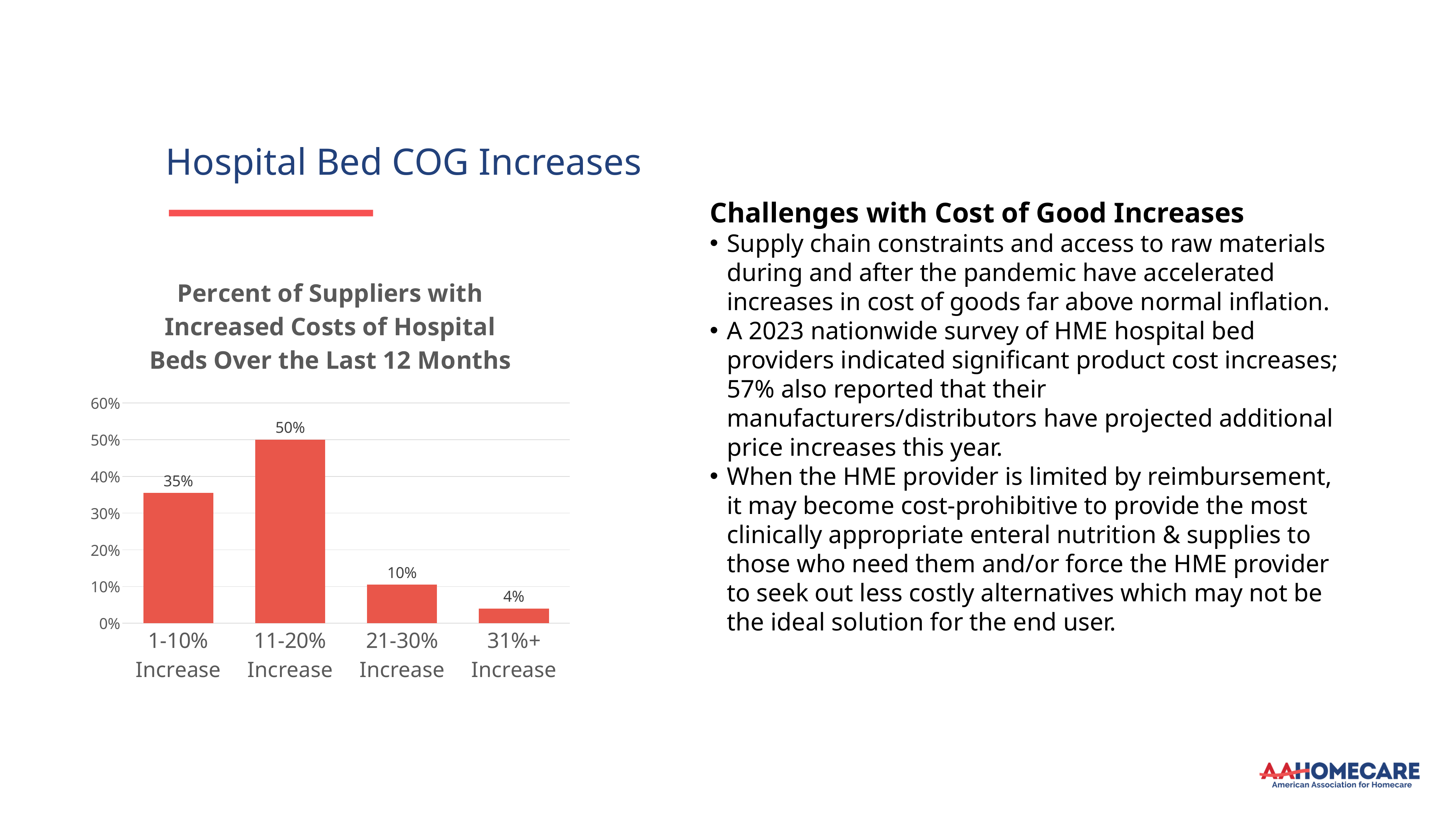
What percent of suppliers reported a 1-10% increase in hospital bed costs? 35% What kind of chart is shown on the slide? Bar chart Which cost increase range has the highest percent of suppliers? 11-20% Increase What is the title of the chart on the slide? Percent of Suppliers with Increased Costs of Hospital Beds Over the Last 12 Months Which is larger: the percent of suppliers with a 21-30% increase or with a 31%+ increase? 21-30% Increase What is the difference between the percent of suppliers in the 11-20% Increase range and the 1-10% Increase range? 15% What percent of suppliers reported an 11-20% increase in hospital bed costs? 50% Is the value for the 1-10% Increase category greater or less than 40%? less What percent of suppliers reported a 31%+ increase in hospital bed costs? 4% What percent of suppliers reported a 21-30% increase in hospital bed costs? 10% How many cost increase categories are shown on the x axis of the chart? 4 Which cost increase range has the lowest percent of suppliers? 31%+ Increase